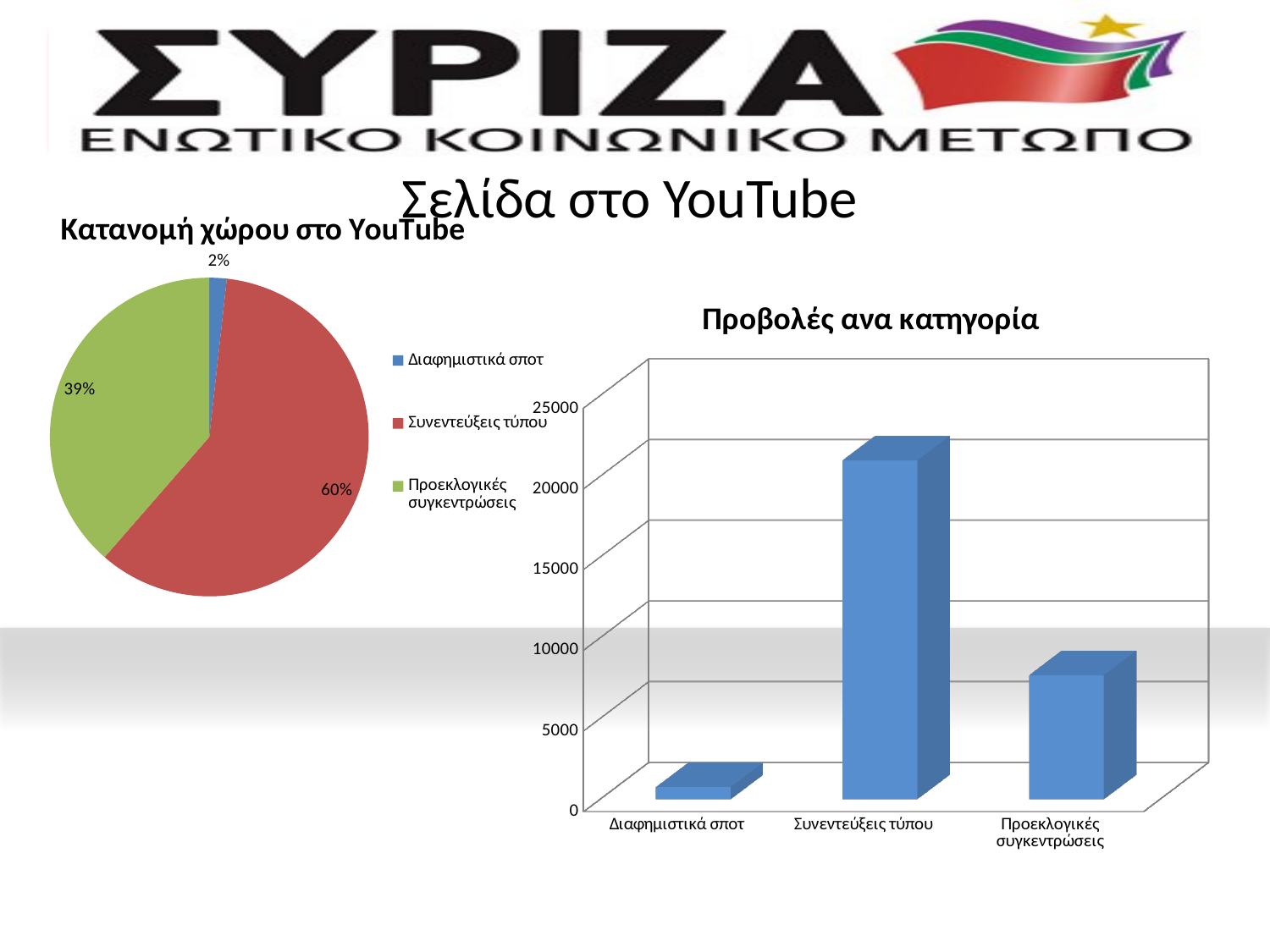
In the pie chart 'Κατανομή χώρου στο YouTube', which category has the largest slice? Συνεντεύξεις τύπου In the chart 'Προβολές ανα κατηγορία', is the value for Προεκλογικές συγκεντρώσεις greater or less than 10000? less What kind of chart is 'Προβολές ανα κατηγορία'? Bar chart In the chart 'Προβολές ανα κατηγορία', which category has the highest value? Συνεντεύξεις τύπου In the pie chart 'Κατανομή χώρου στο YouTube', what share is shown for Προεκλογικές συγκεντρώσεις? 39% In the pie chart 'Κατανομή χώρου στο YouTube', how many categories does the legend list? 3 In the chart 'Προβολές ανα κατηγορία', is the value for Συνεντεύξεις τύπου greater or less than 20000? greater In the pie chart 'Κατανομή χώρου στο YouTube', which category has the smallest slice? Διαφημιστικά σποτ In the pie chart 'Κατανομή χώρου στο YouTube', what share is shown for Διαφημιστικά σποτ? 2% In the chart 'Προβολές ανα κατηγορία', which category has the lowest value? Διαφημιστικά σποτ In the pie chart 'Κατανομή χώρου στο YouTube', how many percentage points larger is the Συνεντεύξεις τύπου slice than the Προεκλογικές συγκεντρώσεις slice? 21 In the pie chart 'Κατανομή χώρου στο YouTube', what share is shown for Συνεντεύξεις τύπου? 60%